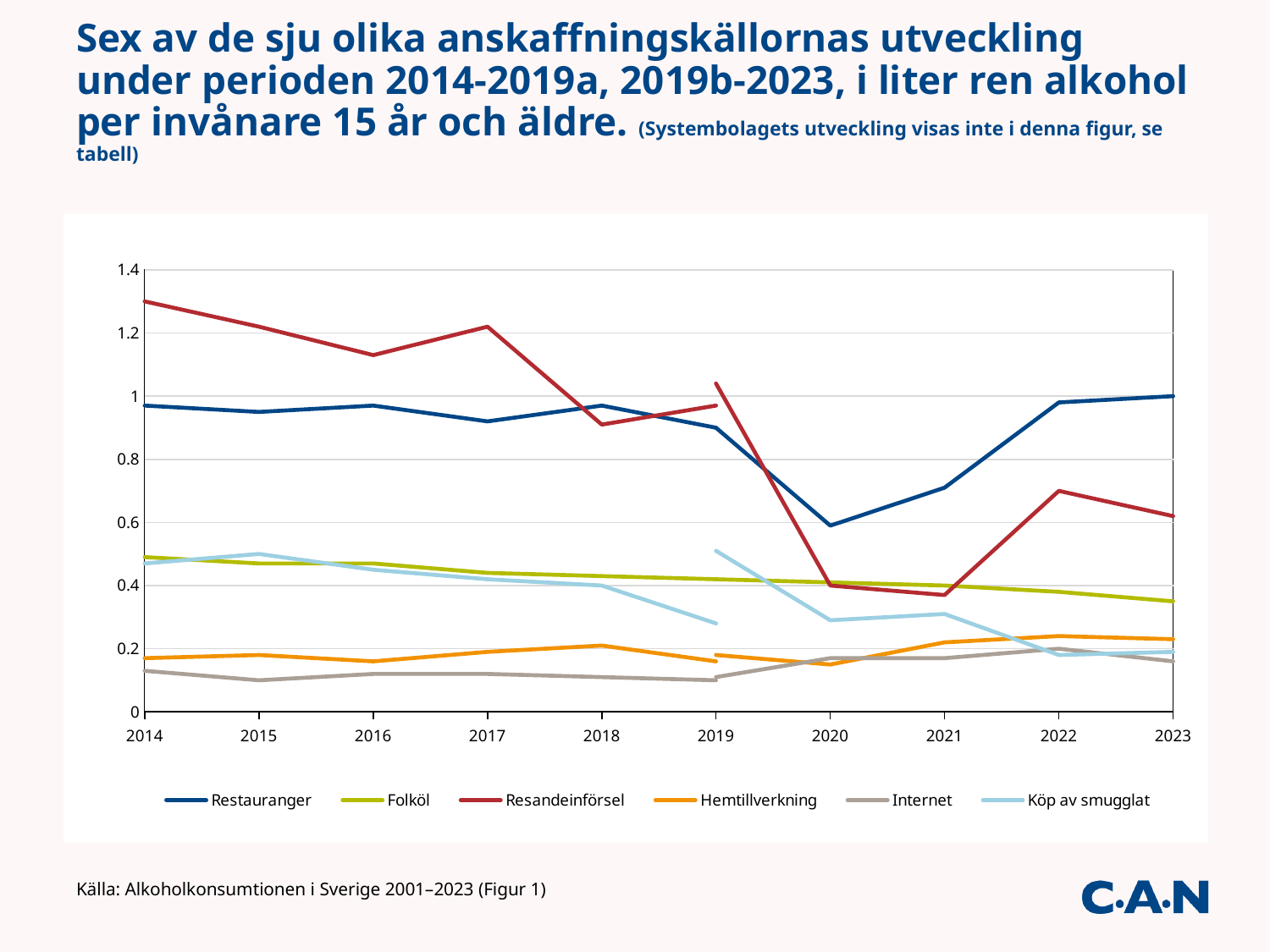
Is the value for Köp av smugglat in 2015 greater or less than 0.4? greater In 2023, which is larger: Restauranger or Resandeinförsel? Restauranger Is the value for Folköl in 2023 greater or less than 0.4? less Does the Folköl series rise or fall from 2014 to 2023? Falls Is the value for Restauranger in 2020 greater or less than 0.8? less Which series has the highest value in 2023? Restauranger How many series does the legend list? 6 Which series has the highest value in 2014? Resandeinförsel Which series has the lowest value in 2014? Internet What kind of chart is shown on the slide? Line chart How many years are labelled on the x axis? 10